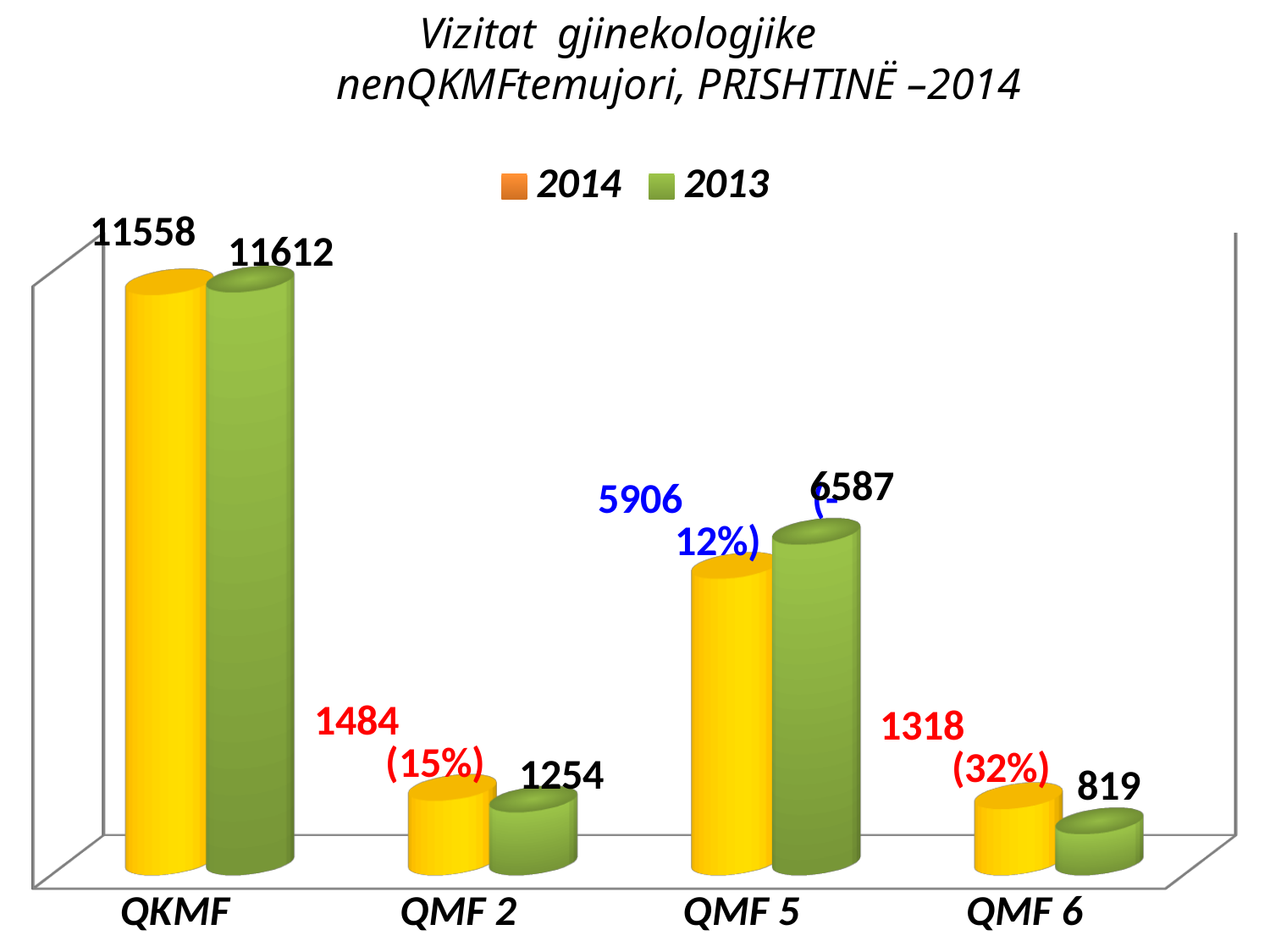
What is the 2014 value for QMF 6? 1318 What is the 2013 value for QMF 2? 1254 What is the 2013 value for QMF 5? 6587 How many categories are shown on the x axis? 4 How many series does the legend list? 2 Which series is shown in green in the legend? 2013 What type of chart is shown on the slide? bar chart What is the 2014 value for QKMF? 11558 Which category has the lowest 2013 value? QMF 6 For QMF 5, which is larger: the 2014 value or the 2013 value? 2013 What is the difference between the 2014 and 2013 values for QMF 6? 499 Which category has the highest 2014 value? QKMF